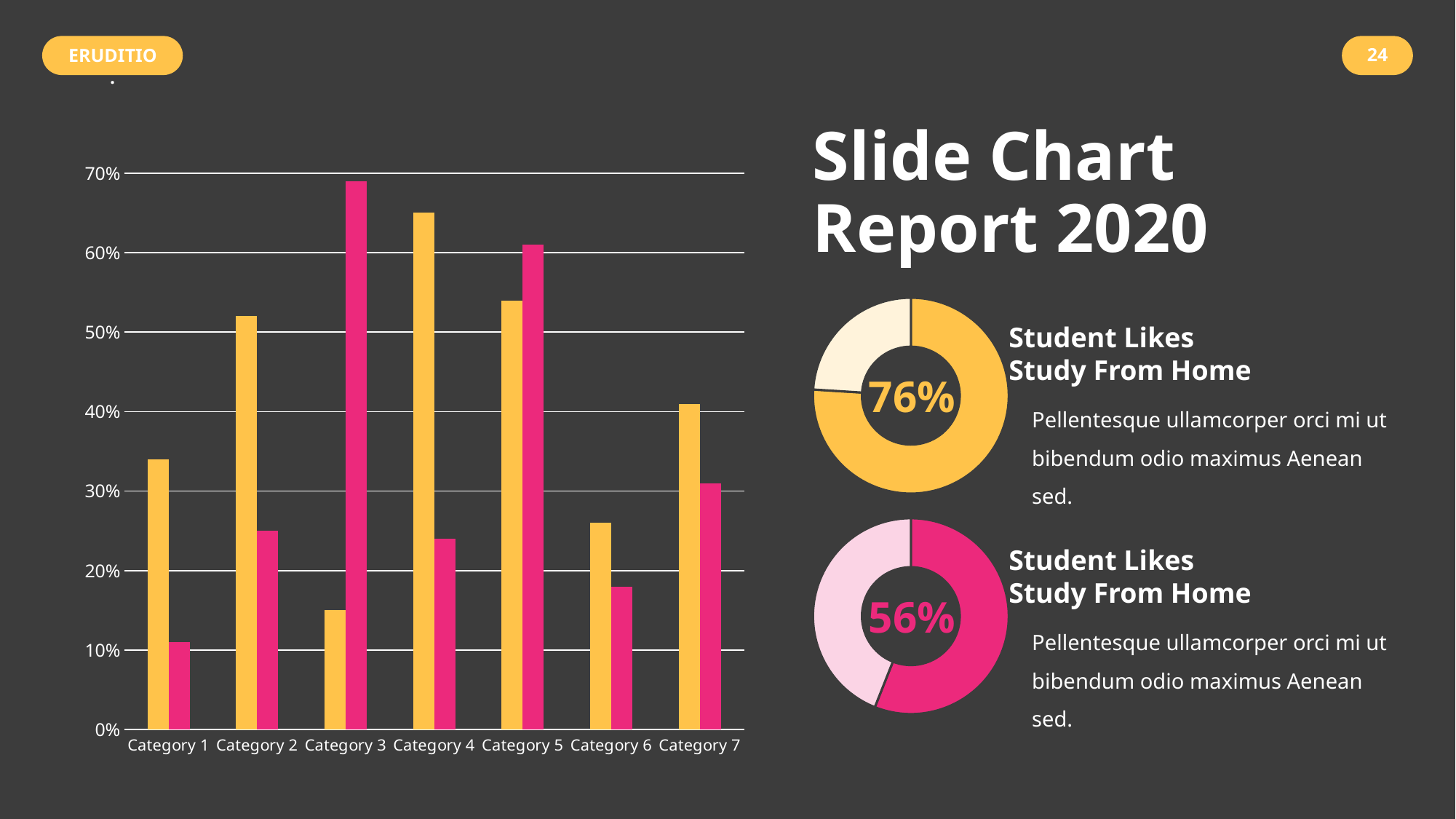
On the bar chart on the left, in Category 5, which bar is taller, the yellow one or the pink one? the pink one On the bar chart on the left, which category has the tallest pink bar? Category 3 What percentage is shown in the centre of the yellow donut chart on the right? 76% On the bar chart on the left, which category has the shortest pink bar? Category 1 On the bar chart on the left, which category has the tallest yellow bar? Category 4 On the bar chart on the left, is the pink bar for Category 3 greater or less than 60%? greater On the bar chart on the left, which category has the shortest yellow bar? Category 3 What percentage is shown in the centre of the pink donut chart on the right? 56% On the bar chart on the left, how many categories are shown on the x axis? 7 On the bar chart on the left, in Category 2, which bar is taller, the yellow one or the pink one? the yellow one On the bar chart on the left, is the yellow bar for Category 6 greater or less than 30%? less What kind of chart is the chart on the left of the slide? bar chart